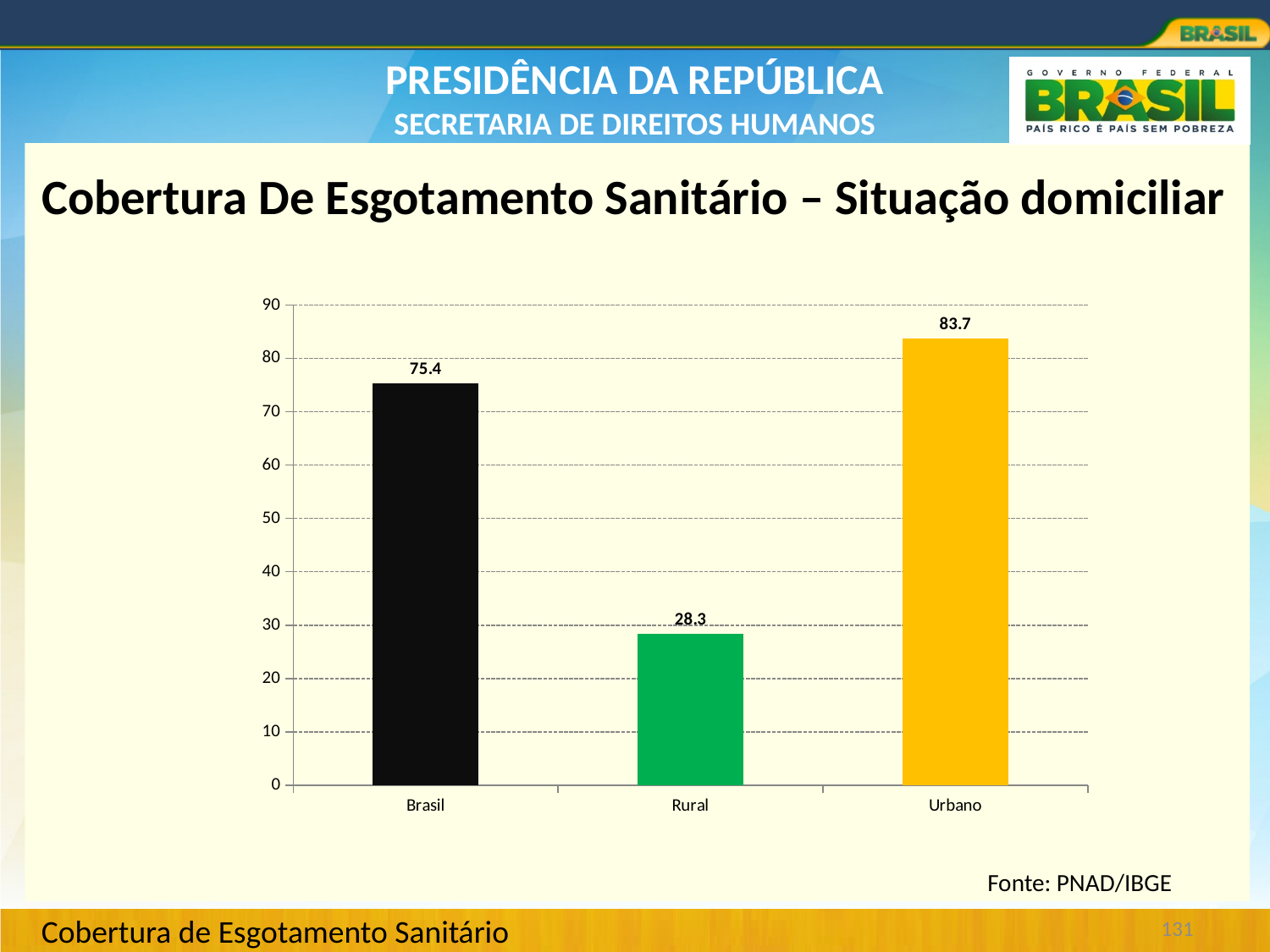
Which category has the highest value? Urbano What is the value for Urbano? 83.7 What kind of chart is shown on the slide? bar chart What is the value for Brasil? 75.4 What colour is the bar for Rural? green What is the difference between the values for Urbano and Rural? 55.4 Which category has the lowest value? Rural What is the value for Rural? 28.3 Which is larger, the value for Brasil or the value for Rural? Brasil Is the value for Rural greater or less than 30? less How many categories are shown on the x axis? 3 What is the difference between the values for Urbano and Brasil? 8.3